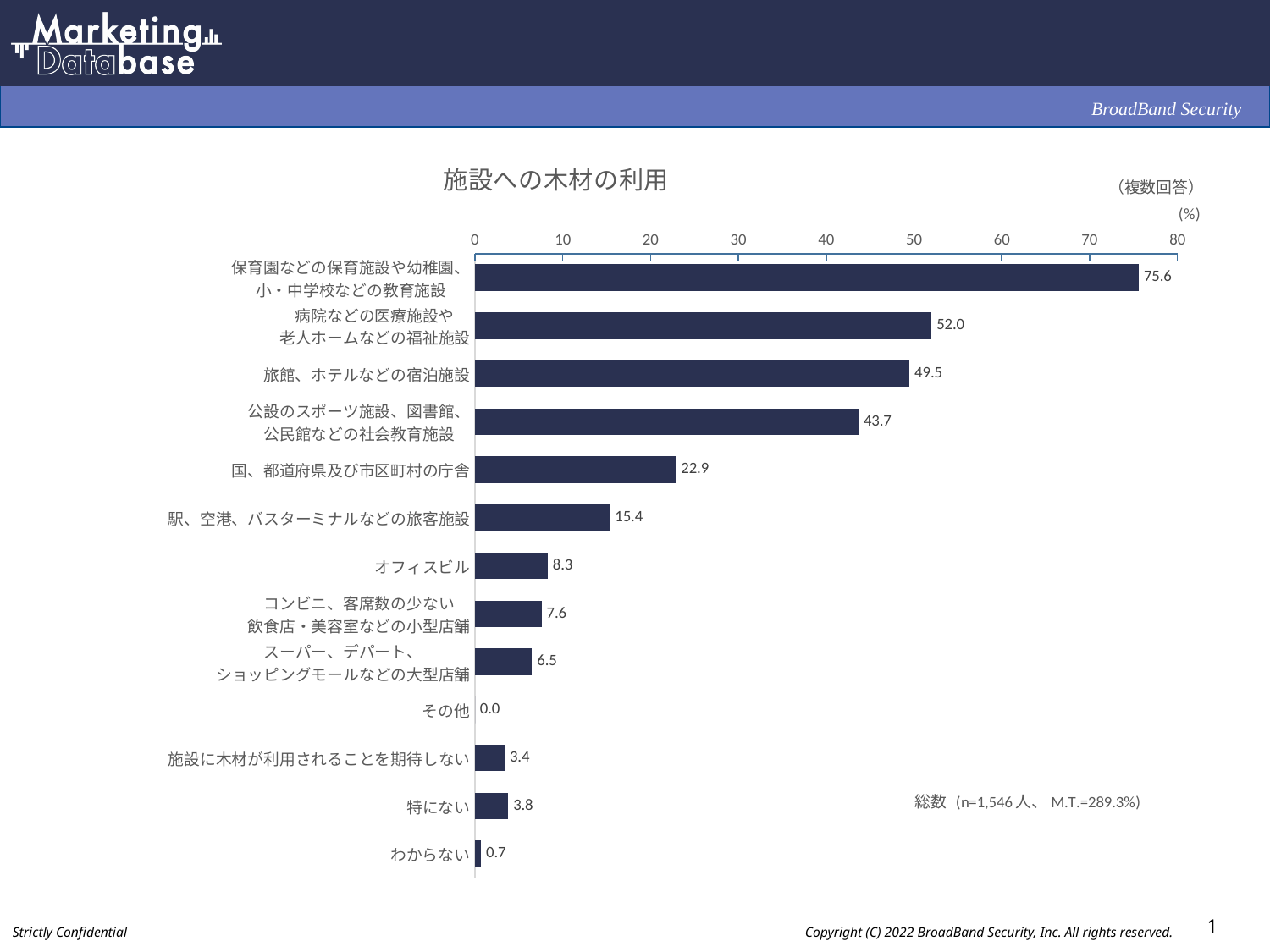
What is the value for オフィスビル? 8.3 Is the value for 公設のスポーツ施設、図書館、公民館などの社会教育施設 greater or less than 40? greater What is the title of the chart? 施設への木材の利用 Which category has the highest value? 保育園などの保育施設や幼稚園、小・中学校などの教育施設 What type of chart is shown on the slide? Bar chart What is the value for わからない? 0.7 How many categories are shown in the chart? 13 Which category has the lowest value? その他 What is the difference between the values for 病院などの医療施設や老人ホームなどの福祉施設 and 旅館、ホテルなどの宿泊施設? 2.5 Which is larger, the value for 駅、空港、バスターミナルなどの旅客施設 or the value for オフィスビル? 駅、空港、バスターミナルなどの旅客施設 What is the value for 国、都道府県及び市区町村の庁舎? 22.9 What is the value for 旅館、ホテルなどの宿泊施設? 49.5